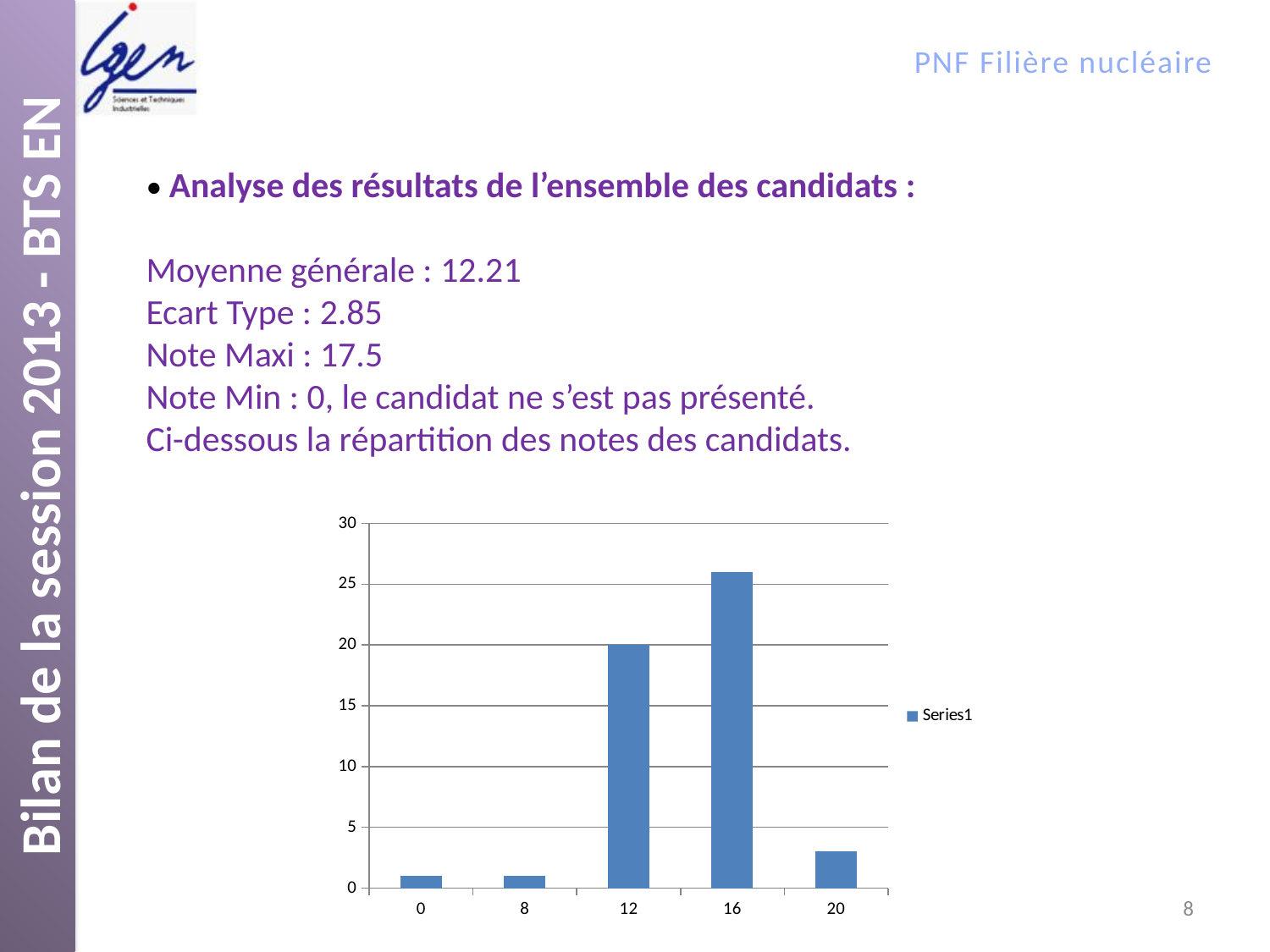
How many categories are shown on the x axis of the chart? 5 Is the value for category 20 greater or less than 5? less Which is larger, the bar for category 12 or the bar for category 16? 16 Do the values rise or fall from category 16 to category 20? fall Which category has the highest bar in the chart? 16 How many series does the chart legend list? 1 What is the name of the series shown in the chart legend? Series1 What kind of chart is shown on the slide? bar chart What is the value of the bar for category 12? 20 Is the value for category 0 greater or less than 5? less Is the value for category 16 greater or less than 25? greater Which is larger, the bar for category 20 or the bar for category 12? 12